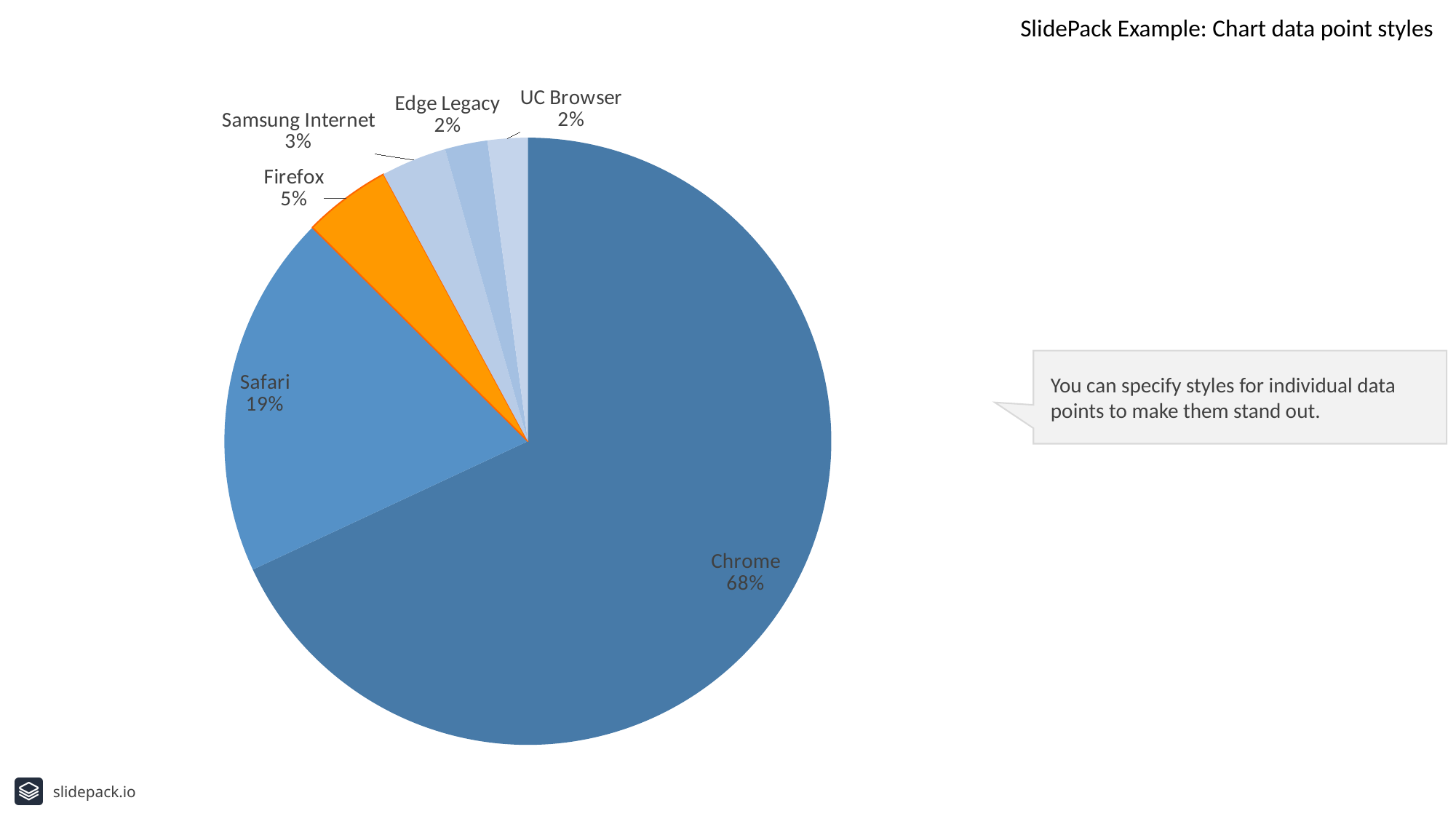
What kind of chart is shown on the slide? Pie chart Which has a larger share, Safari or Firefox? Safari What share of the pie does Safari have? 19% Which browser has the largest slice of the pie? Chrome What share of the pie does Chrome have? 68% What share of the pie does Firefox have? 5% Which has a larger share, Firefox or Samsung Internet? Firefox How many slices does the pie chart have? 6 What is the difference in percentage points between Chrome and Safari? 49 Which slice of the pie is coloured orange? Firefox What is the difference in percentage points between Safari and Firefox? 14 What share of the pie does Samsung Internet have? 3%